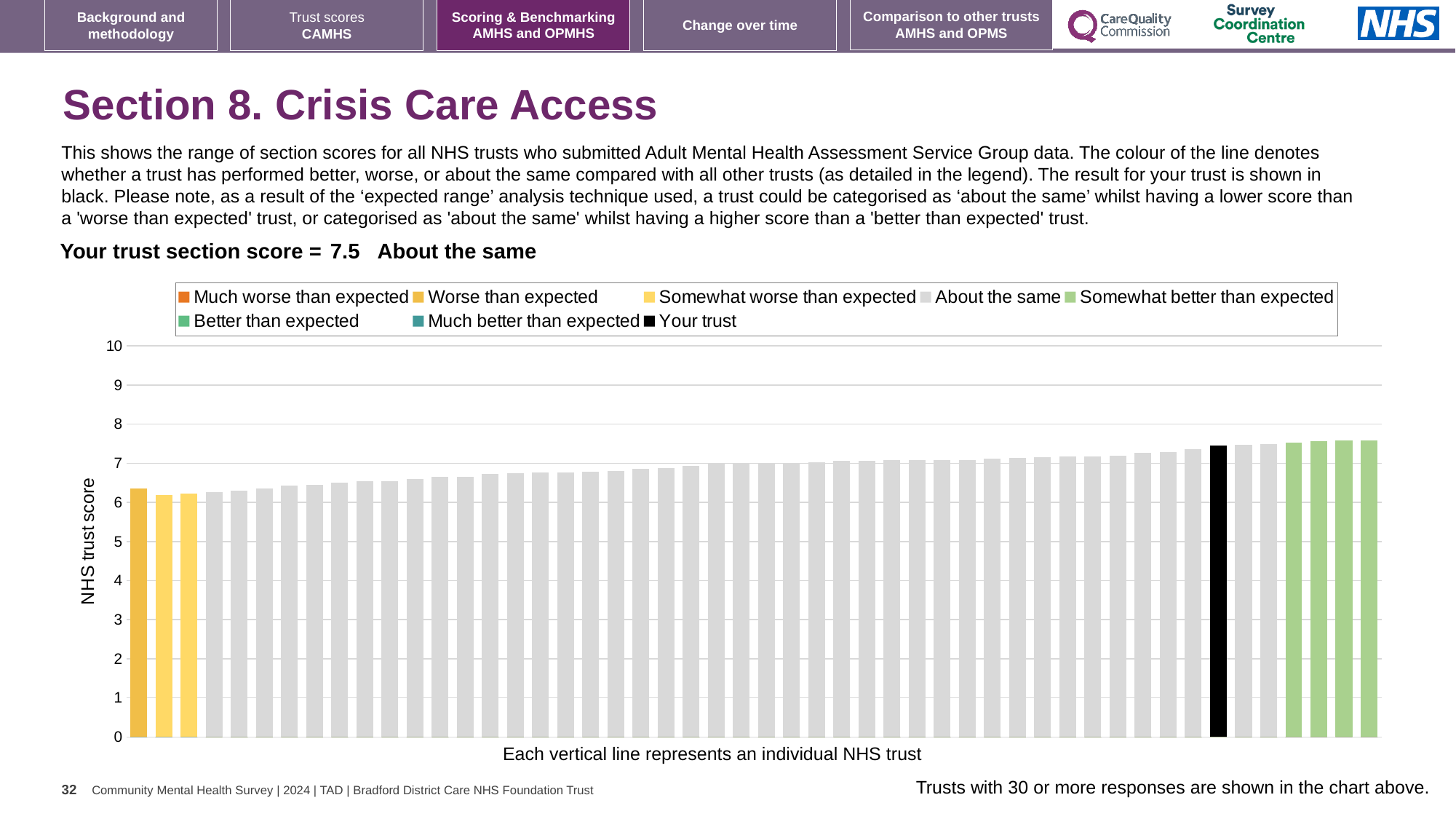
What is the section score for your trust shown on the slide? 7.5 How many bars are coloured green (somewhat better than expected)? 4 What kind of chart is shown on the slide? bar chart Is the value of the leftmost bar greater or less than 5? greater What is the label on the vertical axis of the chart? NHS trust score How many entries does the chart legend list? 8 What colour is the bar representing your trust? black Do the bar values rise or fall from left to right along the x axis? rise Is the value of the black 'Your trust' bar greater or less than 8? less Is the value of the rightmost bar greater or less than 8? less Which performance category is your trust placed in for Crisis Care Access? About the same